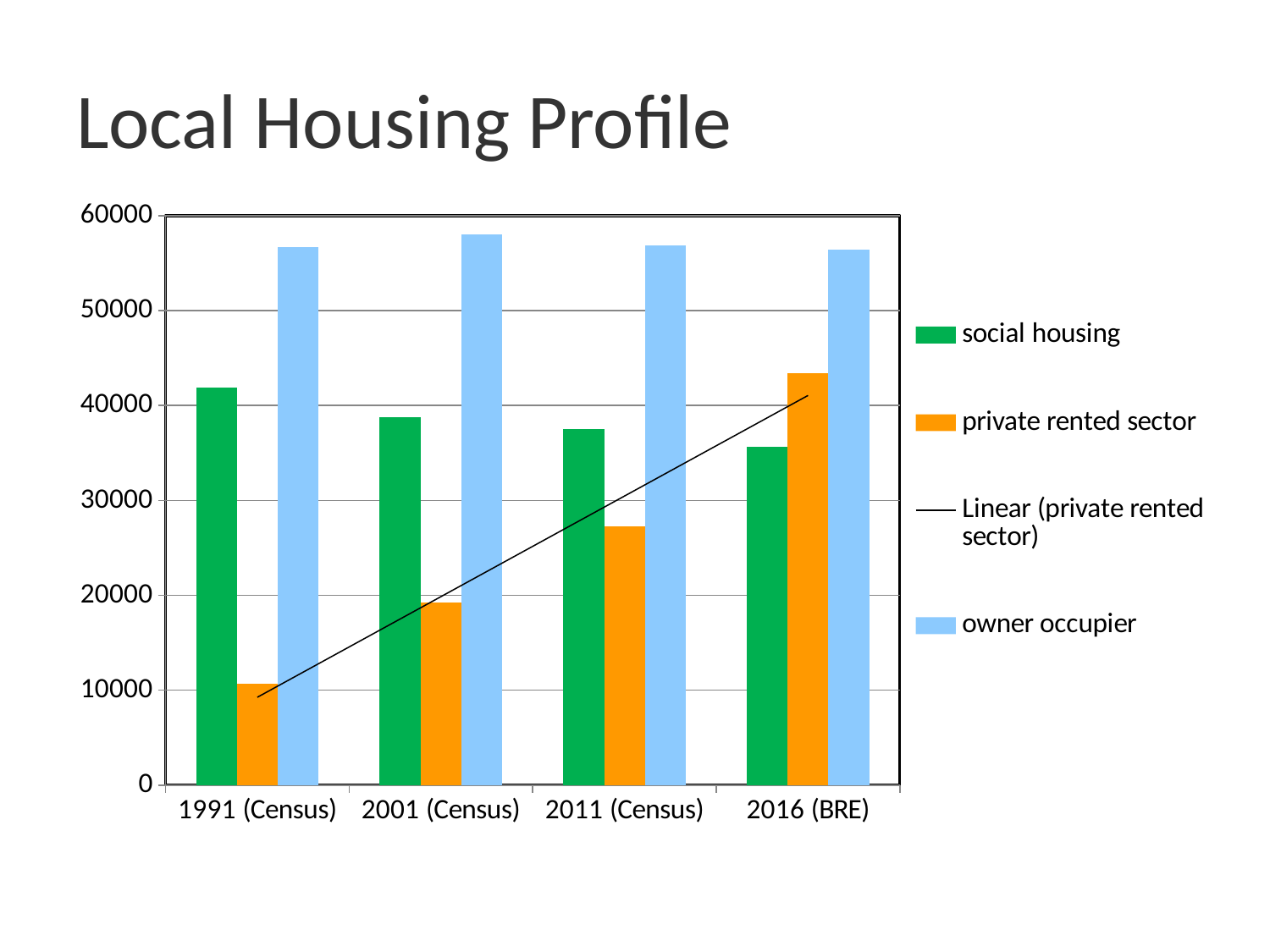
What kind of chart is shown on the slide? bar chart Which category has the highest social housing value? 1991 (Census) Which category has the highest private rented sector value? 2016 (BRE) How many entries does the legend list? 4 Is the private rented sector value for 2016 (BRE) greater or less than 40000? greater What is the title of the slide? Local Housing Profile Do the social housing values rise or fall from 1991 (Census) to 2016 (BRE)? fall In 2016 (BRE), which is larger: social housing or private rented sector? private rented sector Which category has the lowest private rented sector value? 1991 (Census) How many categories are shown along the x axis? 4 Is the private rented sector value for 2001 (Census) greater or less than 20000? less Do the private rented sector values rise or fall from 1991 (Census) to 2016 (BRE)? rise